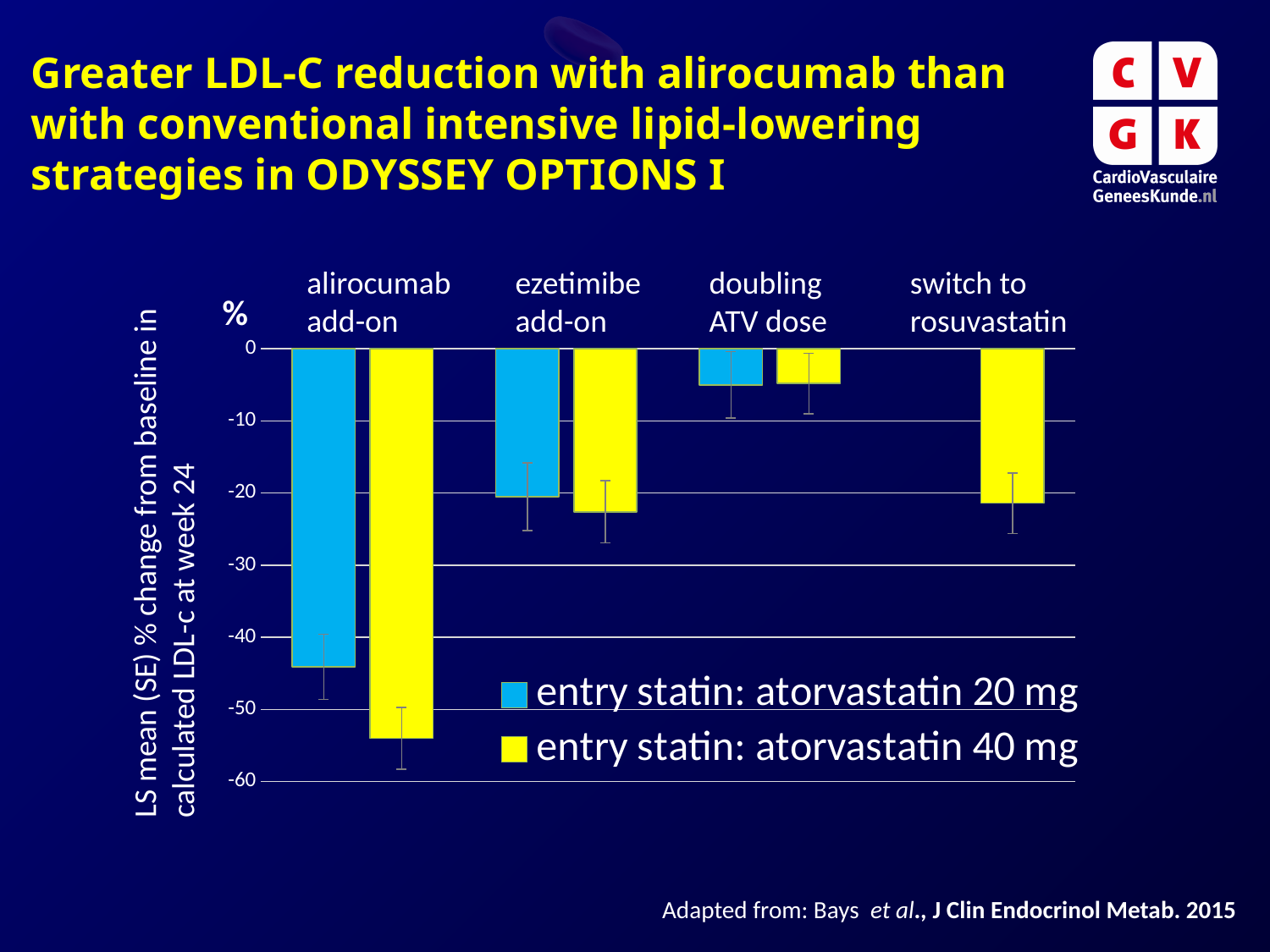
Is the value for alirocumab add-on with entry statin atorvastatin 40 mg greater or less than -50? less Is the value for alirocumab add-on with entry statin atorvastatin 20 mg greater or less than -40? less What kind of chart is shown on the slide? bar chart What is the label on the y axis of the chart? LS mean (SE) % change from baseline in calculated LDL-c at week 24 Is the value for doubling ATV dose with entry statin atorvastatin 20 mg greater or less than -10? greater Which colour represents the entry statin atorvastatin 40 mg series in the chart? yellow How many series does the chart legend list? 2 For patients on entry statin atorvastatin 20 mg, which shows a larger LDL-C reduction: alirocumab add-on or ezetimibe add-on? alirocumab add-on Which treatment category shows the largest LDL-C reduction (the longest bars)? alirocumab add-on For patients on entry statin atorvastatin 40 mg, which shows a larger LDL-C reduction: alirocumab add-on or switch to rosuvastatin? alirocumab add-on How many treatment categories are shown along the x axis of the chart? 4 Which treatment category shows the smallest LDL-C reduction (the shortest bars)? doubling ATV dose